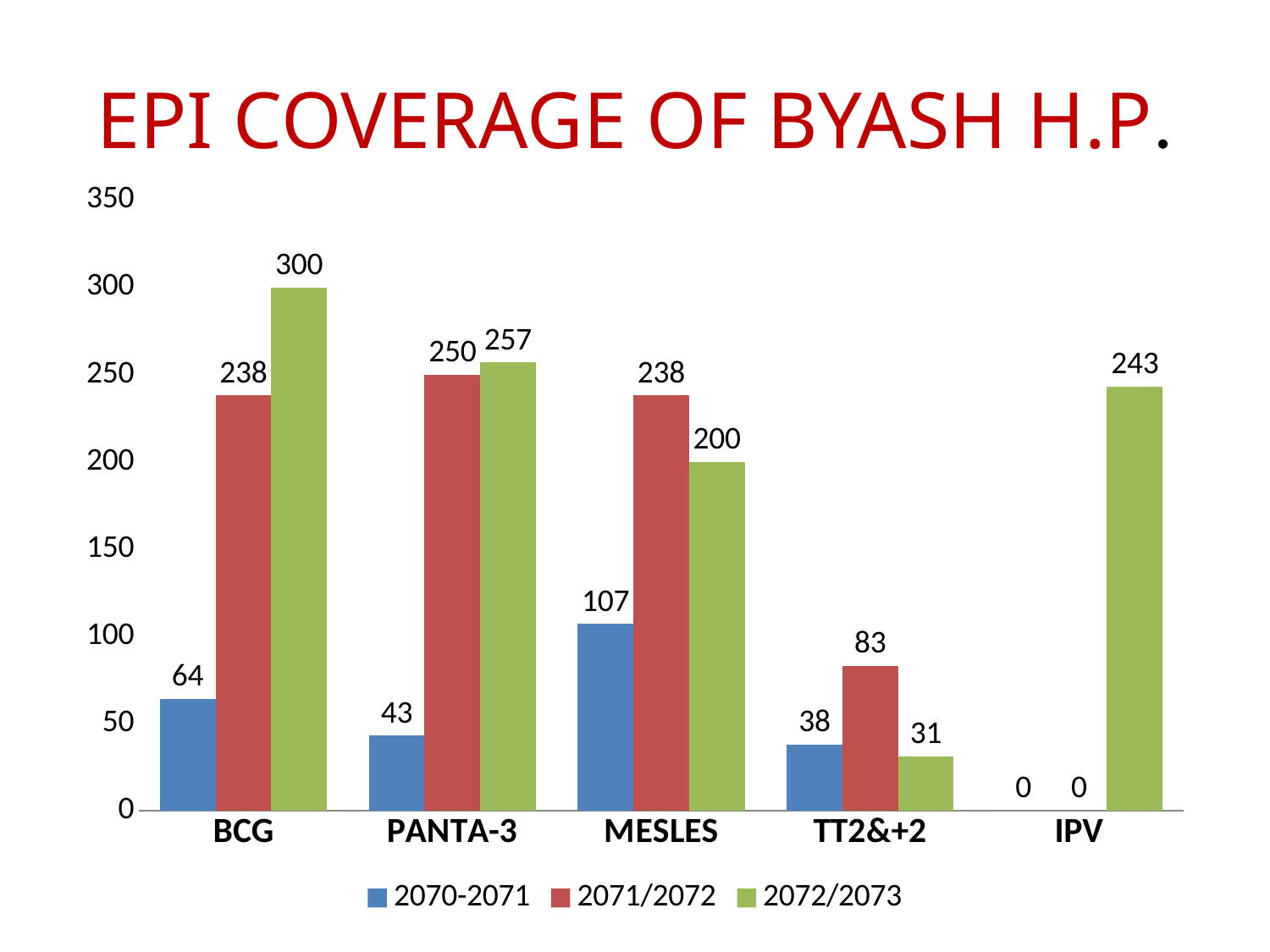
What is the value for IPV in the 2072/2073 series? 243 What is the value for MESLES in the 2070-2071 series? 107 What is the title of the chart? EPI COVERAGE OF BYASH H.P. Which is larger for MESLES: the 2071/2072 value or the 2072/2073 value? 2071/2072 What kind of chart is shown on the slide? bar chart Is the value for PANTA-3 in the 2072/2073 series greater or less than 250? greater What is the difference between the 2072/2073 and 2071/2072 values for BCG? 62 Which category has the lowest value in the 2072/2073 series? TT2&+2 How many categories are shown on the x axis? 5 How many series does the legend list? 3 What is the value for BCG in the 2072/2073 series? 300 Which category has the highest value in the 2071/2072 series? PANTA-3